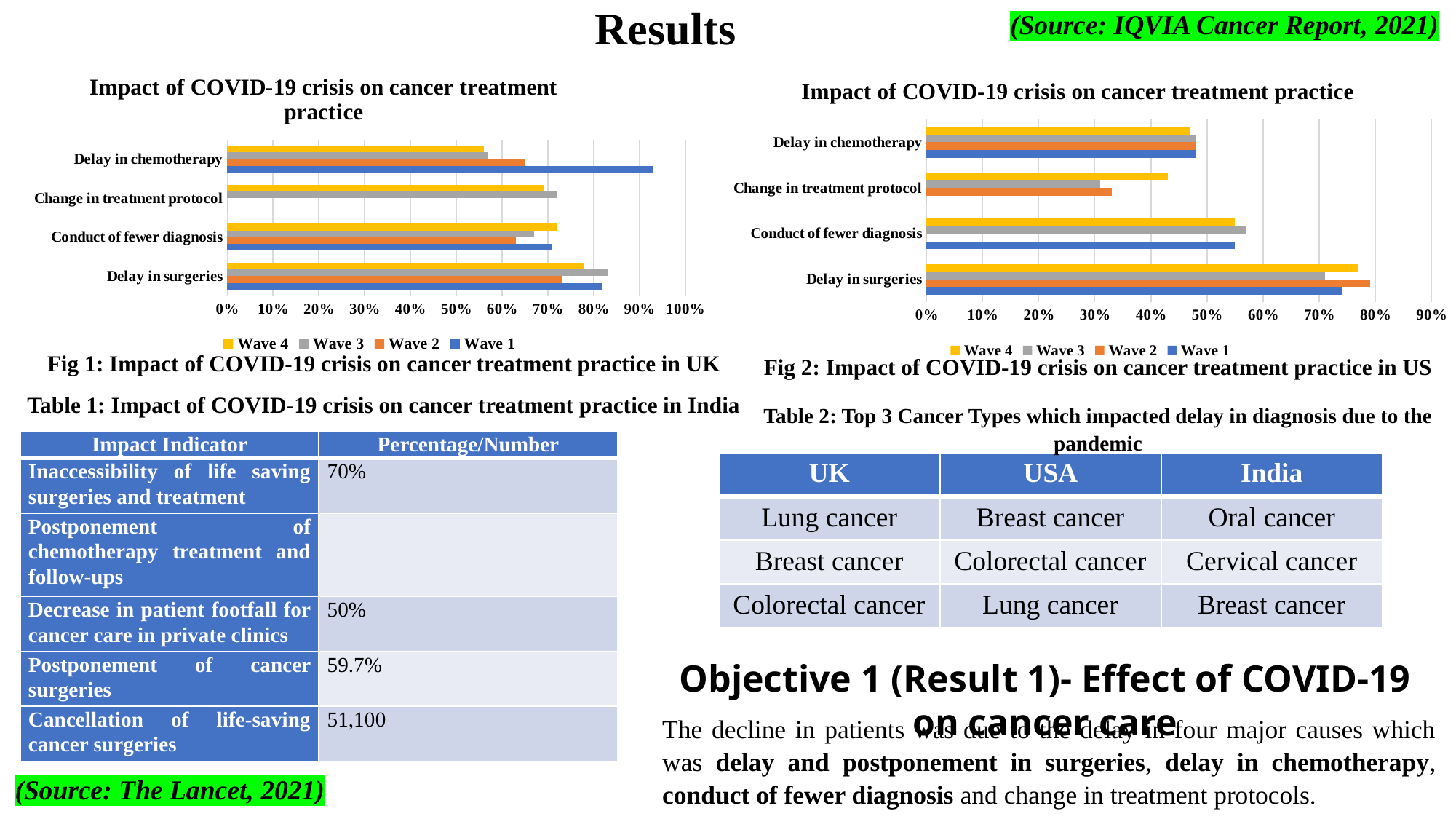
In Fig 2 (US chart), is the Wave 2 value for Delay in surgeries greater or less than 70%? greater In Fig 1 (UK chart), is the Wave 1 value for Delay in chemotherapy greater or less than 90%? greater In Fig 2 (US chart), which category has the highest Wave 2 value? Delay in surgeries In Fig 2 (US chart), which category has the lowest Wave 3 value? Change in treatment protocol In Fig 1 (UK chart), which category has no Wave 1 or Wave 2 bars? Change in treatment protocol In Fig 1 (UK chart), how many series does the legend list? 4 In Fig 1 (UK chart), what kind of chart is used? Bar chart In Fig 2 (US chart), is the Wave 3 value for Change in treatment protocol greater or less than 40%? less In Fig 1 (UK chart), which category has the highest Wave 1 value? Delay in chemotherapy In Fig 2 (US chart), what is the highest tick label shown on the horizontal axis? 90% In Fig 1 (UK chart), for Delay in chemotherapy, which is larger: the Wave 1 value or the Wave 4 value? Wave 1 In Fig 1 (UK chart), how many impact categories are shown on the vertical axis? 4